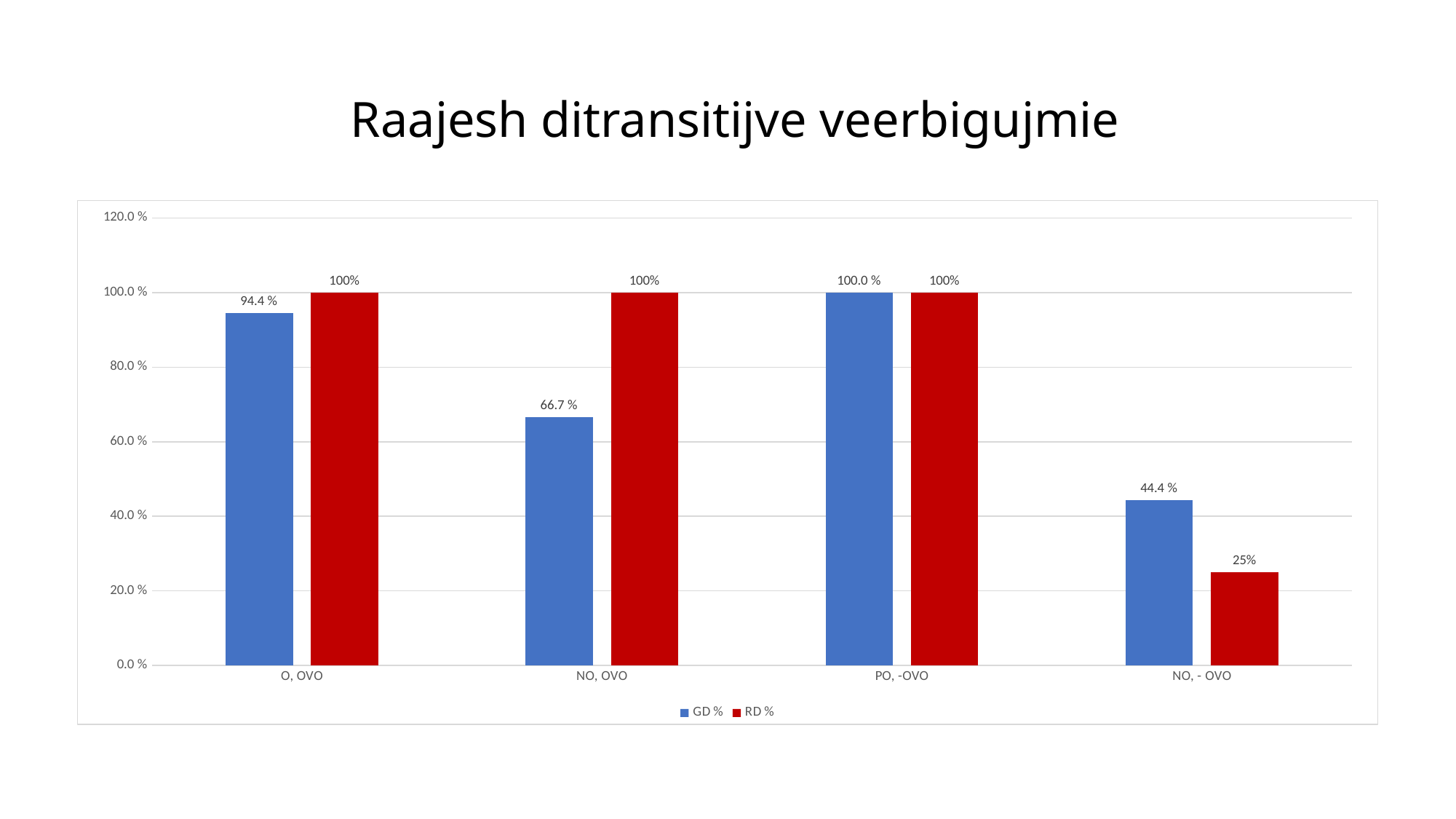
What is the GD % value for NO, OVO? 66.7 % What is the GD % value for O, OVO? 94.4 % What is the difference between the GD % and RD % values for NO, - OVO? 19.4 % Which category has the lowest GD % value? NO, - OVO For NO, OVO, which is larger: the GD % value or the RD % value? RD % Which category has the lowest RD % value? NO, - OVO What is the RD % value for NO, - OVO? 25% What is the GD % value for PO, -OVO? 100.0 % What is the title of the chart? Raajesh ditransitijve veerbigujmie How many categories are shown on the x axis? 4 How many series does the legend list? 2 What kind of chart is shown on the slide? Bar chart